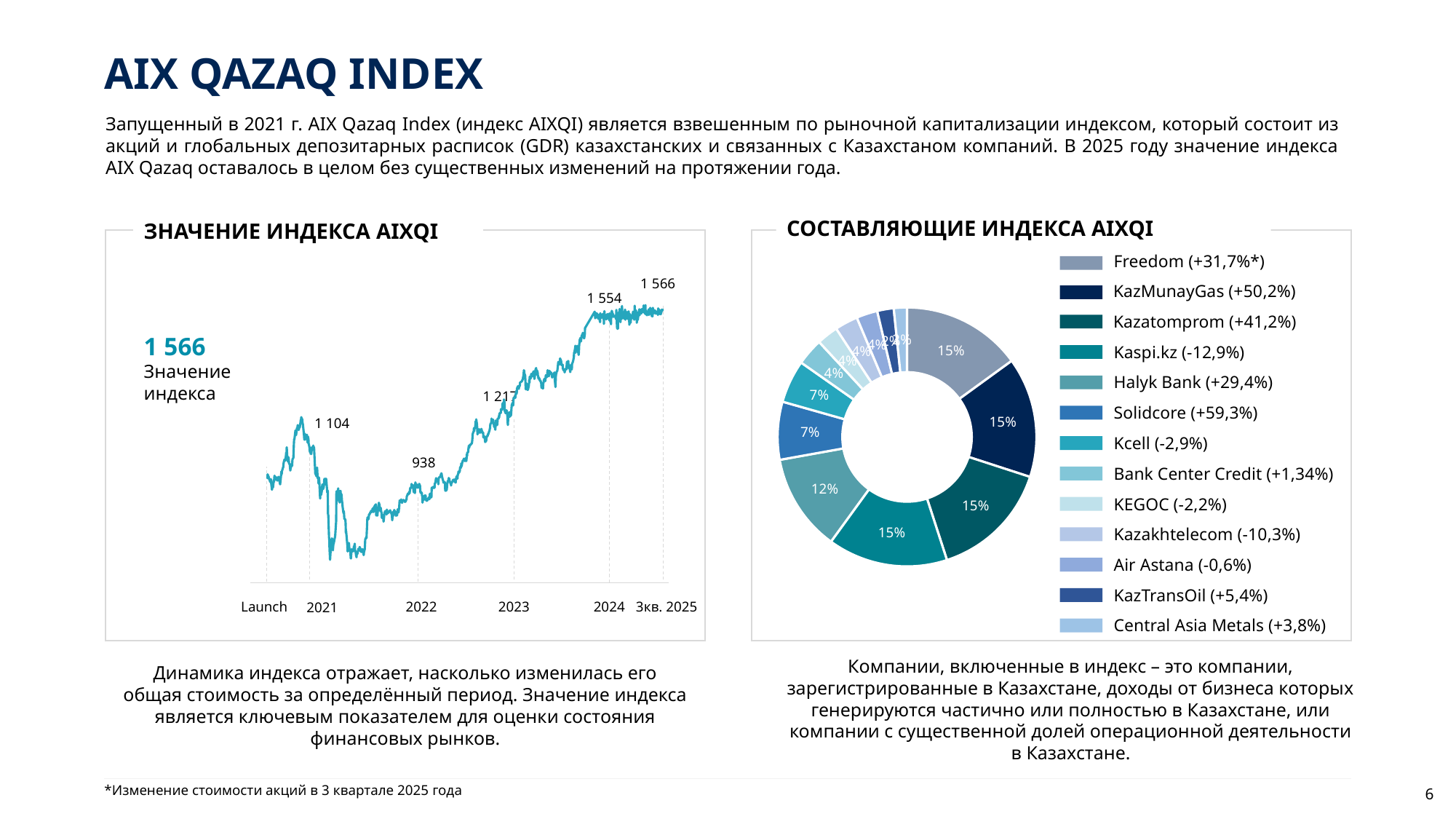
In the chart 'ЗНАЧЕНИЕ ИНДЕКСА AIXQI', what index value is labelled at 2022? 938 In the chart 'ЗНАЧЕНИЕ ИНДЕКСА AIXQI', which labelled value is larger: 2021 or 2023? 2023 How many companies does the legend of the chart 'СОСТАВЛЯЮЩИЕ ИНДЕКСА AIXQI' list? 13 In the chart 'ЗНАЧЕНИЕ ИНДЕКСА AIXQI', what index value is labelled at 2024? 1 554 What kind of chart is the chart titled 'ЗНАЧЕНИЕ ИНДЕКСА AIXQI'? line chart In the chart 'ЗНАЧЕНИЕ ИНДЕКСА AIXQI', does the index rise or fall between the 2022 label and the 2024 label? rise What kind of chart is the chart titled 'СОСТАВЛЯЮЩИЕ ИНДЕКСА AIXQI'? pie chart (donut) In the chart 'ЗНАЧЕНИЕ ИНДЕКСА AIXQI', what is the difference between the labelled values for 3кв. 2025 and 2024? 12 In the chart 'ЗНАЧЕНИЕ ИНДЕКСА AIXQI', what index value is labelled at 3кв. 2025? 1 566 In the chart 'СОСТАВЛЯЮЩИЕ ИНДЕКСА AIXQI', what share of the index does Halyk Bank hold? 12% In the chart 'ЗНАЧЕНИЕ ИНДЕКСА AIXQI', which labelled point has the lowest value? 2022 (938) In the chart 'СОСТАВЛЯЮЩИЕ ИНДЕКСА AIXQI', what share of the index does Solidcore hold? 7%